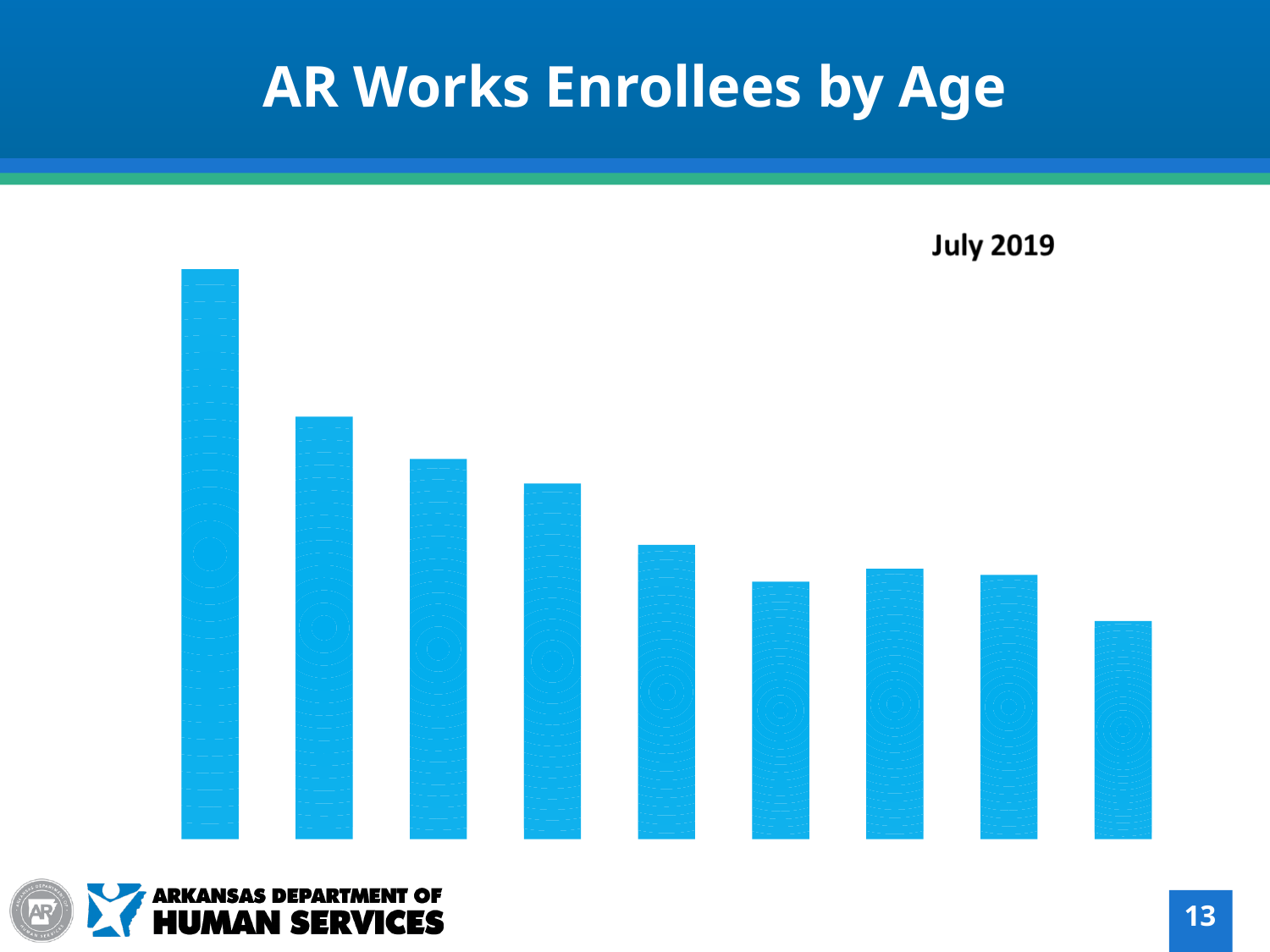
Which bar is the shortest in the chart? the rightmost bar Which bar is the tallest in the chart? the leftmost bar What is the title of the slide containing the chart? AR Works Enrollees by Age Is the leftmost bar taller or shorter than the second bar from the left? taller What kind of chart is shown on the slide? bar chart What date label is shown above the chart? July 2019 Is the rightmost bar taller or shorter than the bar immediately to its left? shorter How many bars does the chart show? 9 Do the bar heights generally rise or fall from left to right? fall